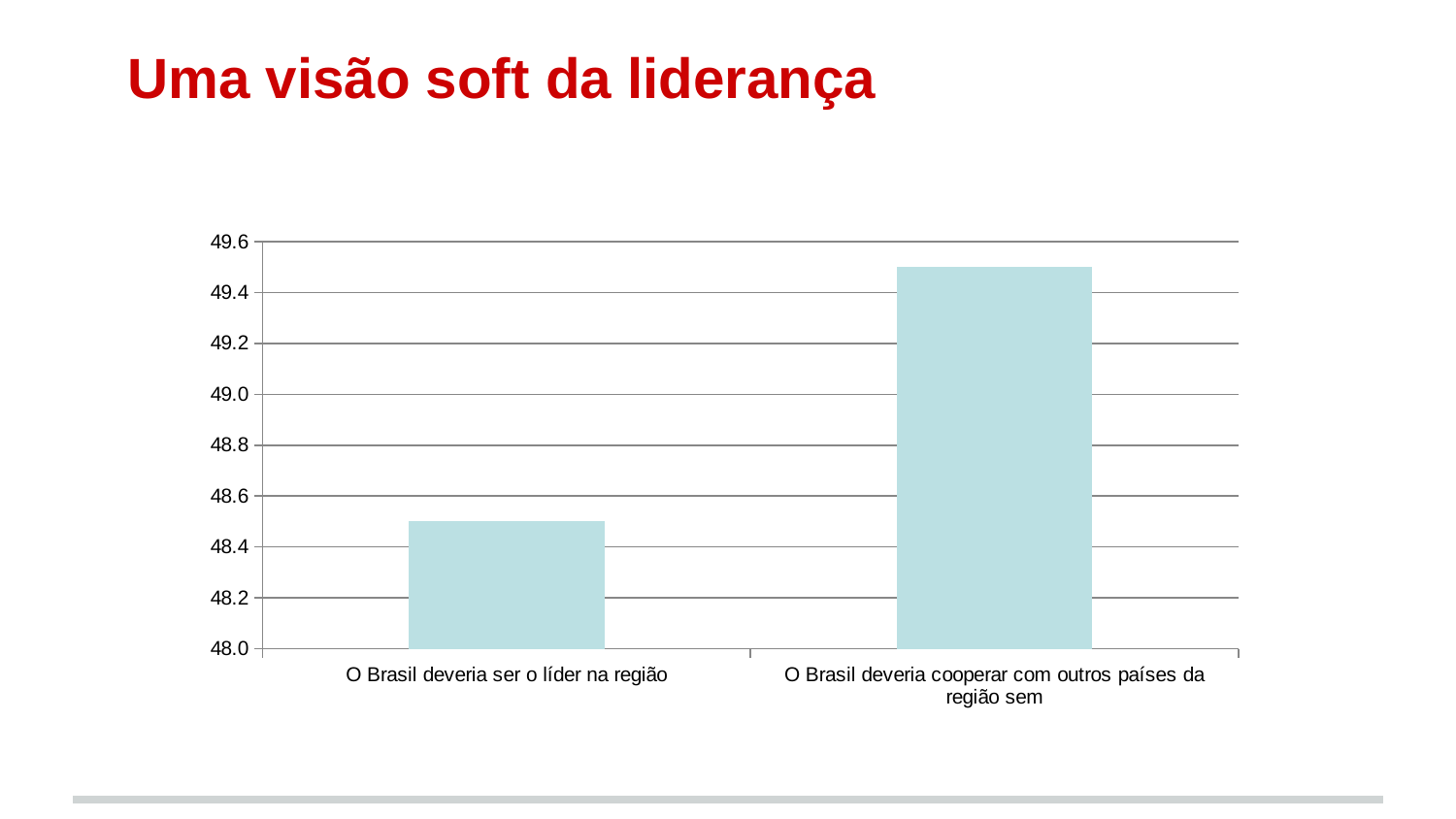
Is the value for "O Brasil deveria ser o líder na região" greater or less than 49.0? less What is the lowest value shown on the vertical axis? 48.0 Which category has the highest value? O Brasil deveria cooperar com outros países da região sem Which category has the lowest value? O Brasil deveria ser o líder na região Is the value for "O Brasil deveria cooperar com outros países da região sem" greater or less than 49.0? greater Is the value for "O Brasil deveria ser o líder na região" greater or less than 48.4? greater What is the title of the slide? Uma visão soft da liderança Which is larger: the value for "O Brasil deveria ser o líder na região" or the value for "O Brasil deveria cooperar com outros países da região sem"? O Brasil deveria cooperar com outros países da região sem How many bars does the chart show? 2 Do the values rise or fall from the left bar to the right bar? rise What kind of chart is shown on the slide? bar chart